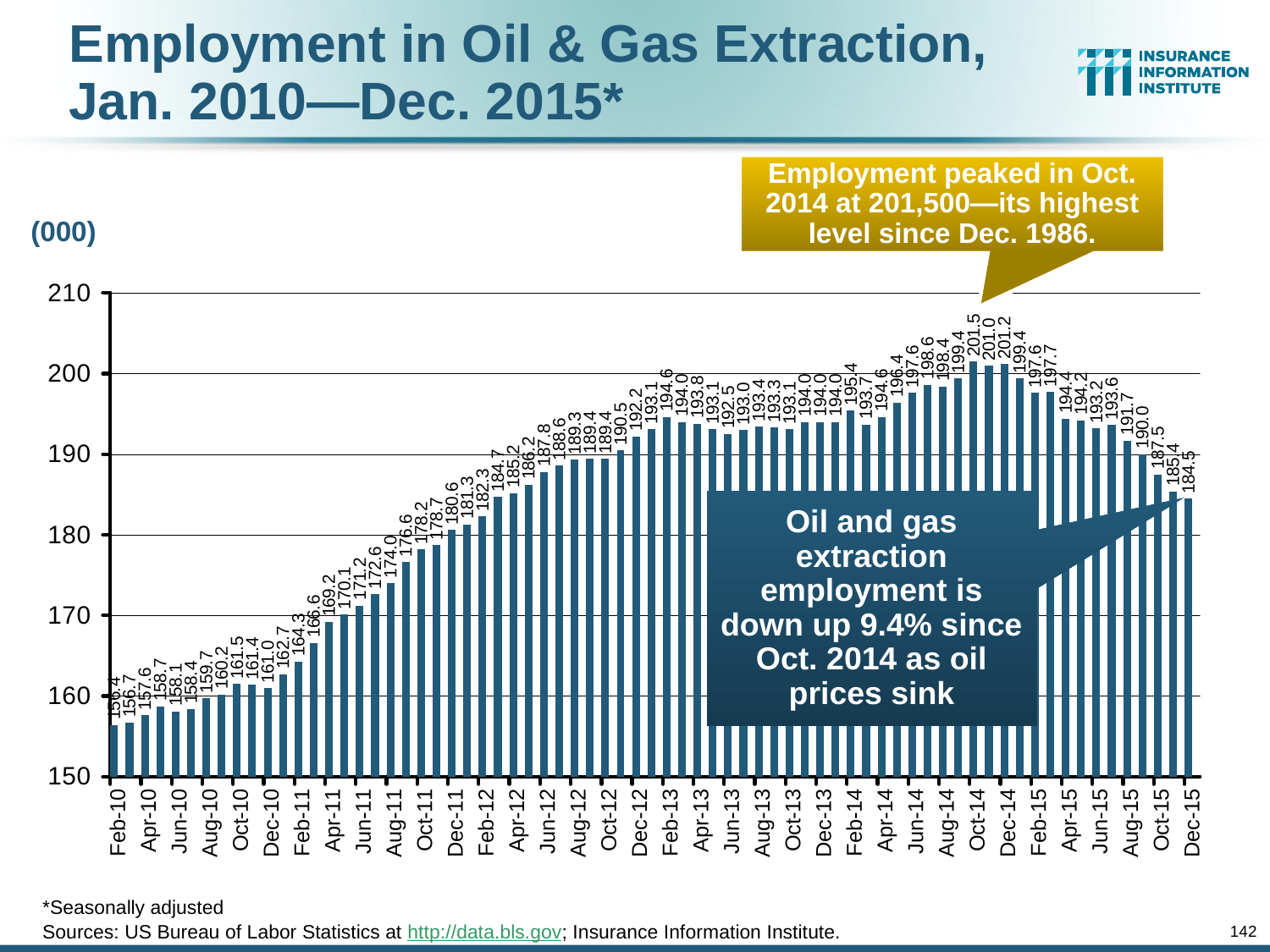
Is the value for Oct-14 greater or less than 200? greater What is the difference between the Oct-14 value and the Dec-15 value? 17.0 Is the value for Dec-15 greater or less than 190? less What was employment in oil and gas extraction in Dec-15? 184.5 Which is larger, the value for Oct-14 or the value for Dec-15? Oct-14 What type of chart is shown on the slide? bar chart In which month did employment reach its highest value on the chart? Oct-14 What is the highest value shown on the chart? 201.5 What was employment in oil and gas extraction in Oct-14, the peak month? 201.5 What was employment in oil and gas extraction in Oct-15? 187.5 Do the values rise or fall from Oct-14 to Dec-15? fall In what units are the values on the chart expressed, according to the axis label? (000)